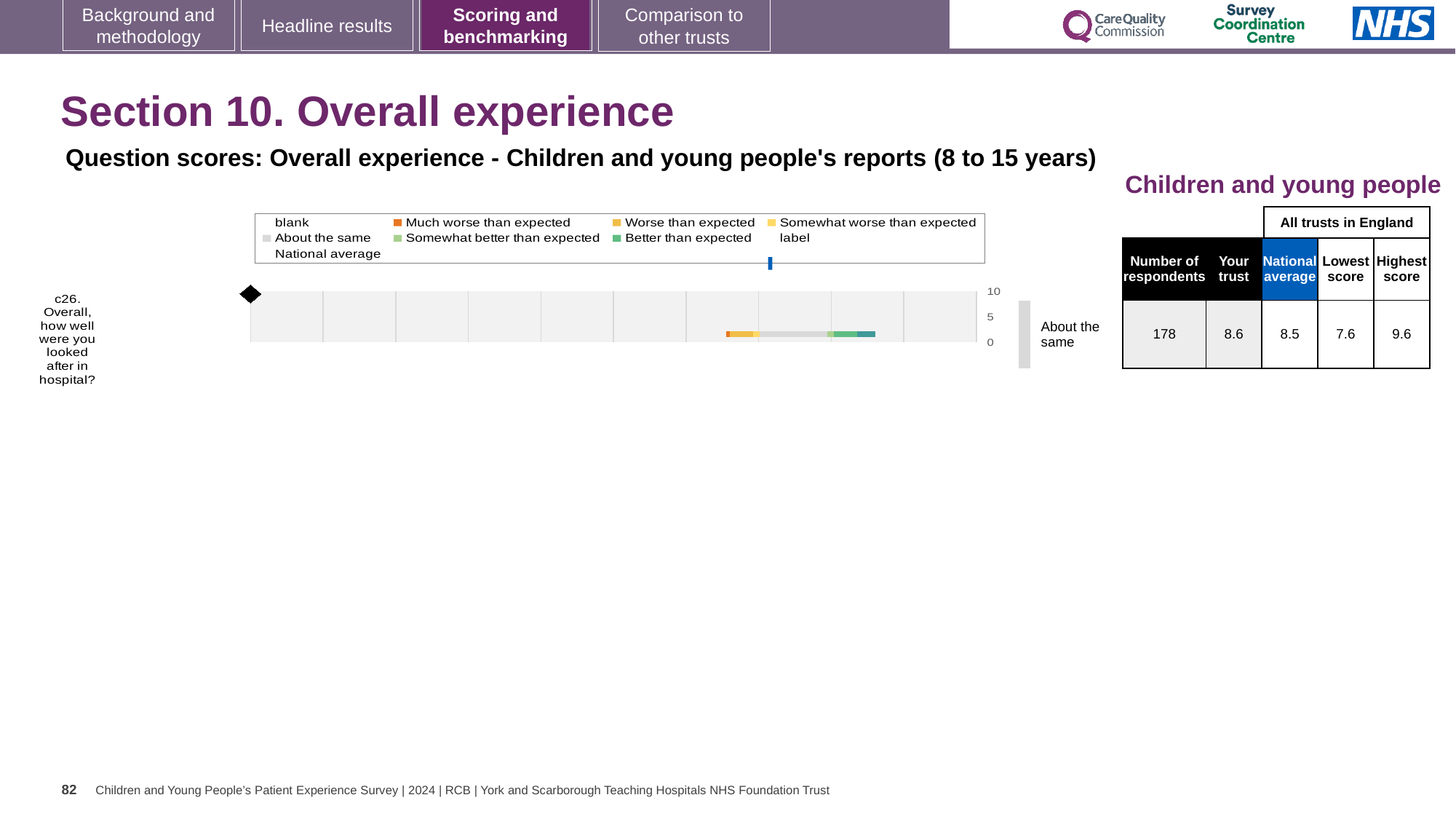
What is the highest score among all trusts in England for question c26? 9.6 What is the lowest score among all trusts in England for question c26? 7.6 How many respondents answered question c26? 178 Which is higher for question c26: the trust's score or the national average? Your trust (8.6) What is the national average score for question c26? 8.5 How many survey questions are plotted in the chart? 1 What benchmark category is the trust's result for question c26 placed in? About the same What type of chart is used to show the question score? Bar chart What is the 'Your trust' score for question c26 'Overall, how well were you looked after in hospital?'? 8.6 What is the difference between the highest and lowest trust scores in England for question c26? 2.0 What is the maximum value shown on the chart's score axis? 10 What is the difference between the trust's score and the national average for question c26? 0.1